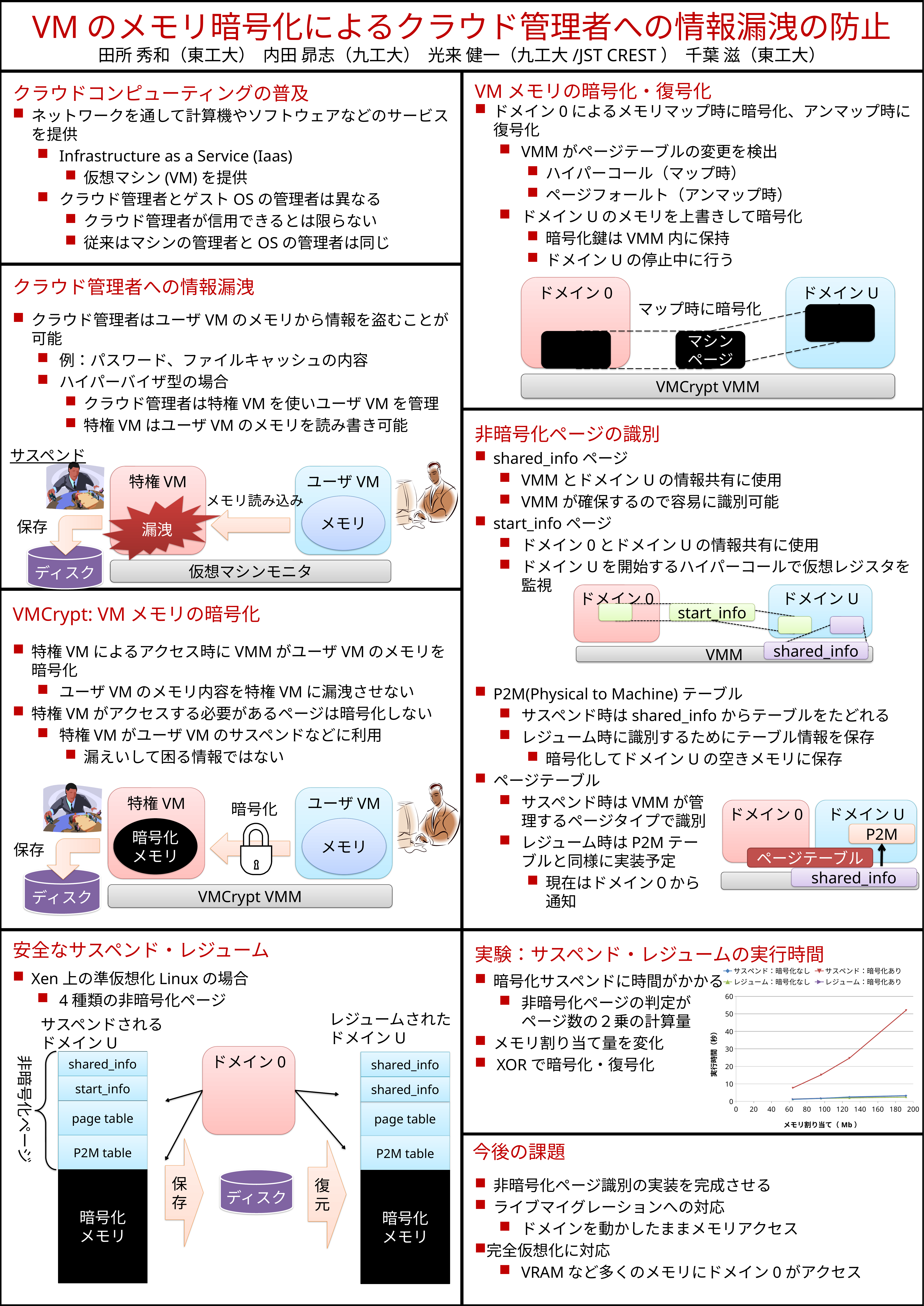
In the line chart, which is larger at the largest memory allocation: サスペンド：暗号化あり or サスペンド：暗号化なし? サスペンド：暗号化あり Which series in the line chart has the highest values? サスペンド：暗号化あり What kind of chart is shown in the 実験：サスペンド・レジュームの実行時間 section? line chart What is the maximum value shown on the y-axis of the line chart? 60 What is the x-axis title of the line chart? メモリ割り当て（Mb） What is the y-axis title of the line chart? 実行時間（秒） In the line chart, is the value for サスペンド：暗号化あり at the smallest memory allocation greater or less than 20? less In the line chart, is the value for サスペンド：暗号化あり at the largest memory allocation greater or less than 40? greater In the line chart, does the サスペンド：暗号化あり series rise or fall as memory allocation increases? rise How many series does the legend of the line chart list? 4 In the line chart, is the value for レジューム：暗号化あり at the largest memory allocation greater or less than 10? less